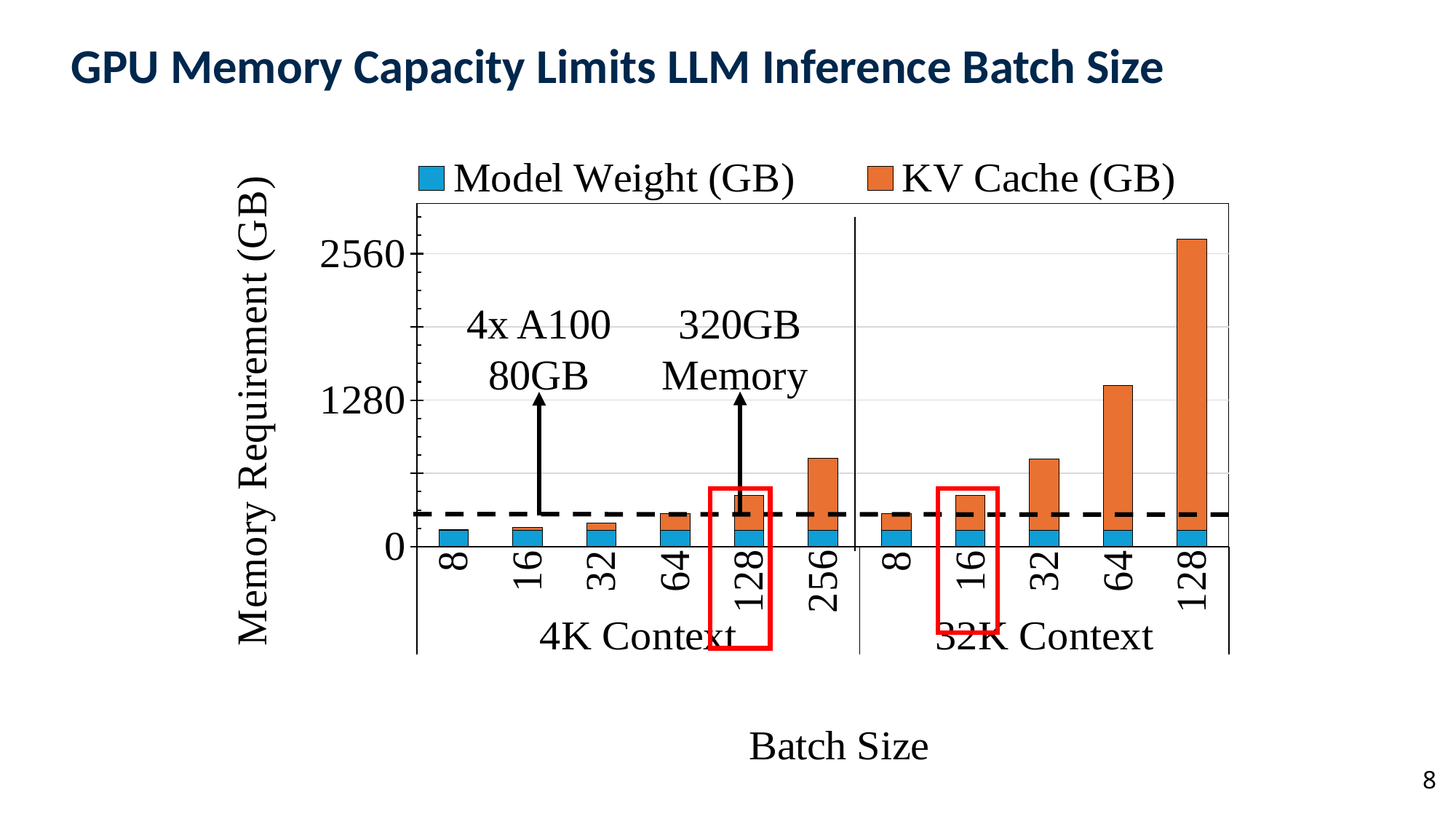
Which batch size and context has the lowest total memory requirement? 8 in 4K Context Is the total memory requirement for batch size 32 in 32K Context greater or less than 1280? less How many series does the legend list? 2 How many bars are plotted in the 32K Context group? 5 What kind of chart is shown on the slide? stacked bar chart Which batch size and context has the highest total memory requirement? 128 in 32K Context What are the two series named in the legend? Model Weight (GB) and KV Cache (GB) What memory capacity does the dashed horizontal line represent? 320GB Memory (4x A100 80GB) How many bars are plotted in the 4K Context group? 6 Is the total memory requirement for batch size 256 in 4K Context greater or less than 1280? less Within the 32K Context group, does the memory requirement rise or fall as batch size increases? rises Which is larger: the total for batch size 256 in 4K Context or batch size 64 in 32K Context? batch size 64 in 32K Context